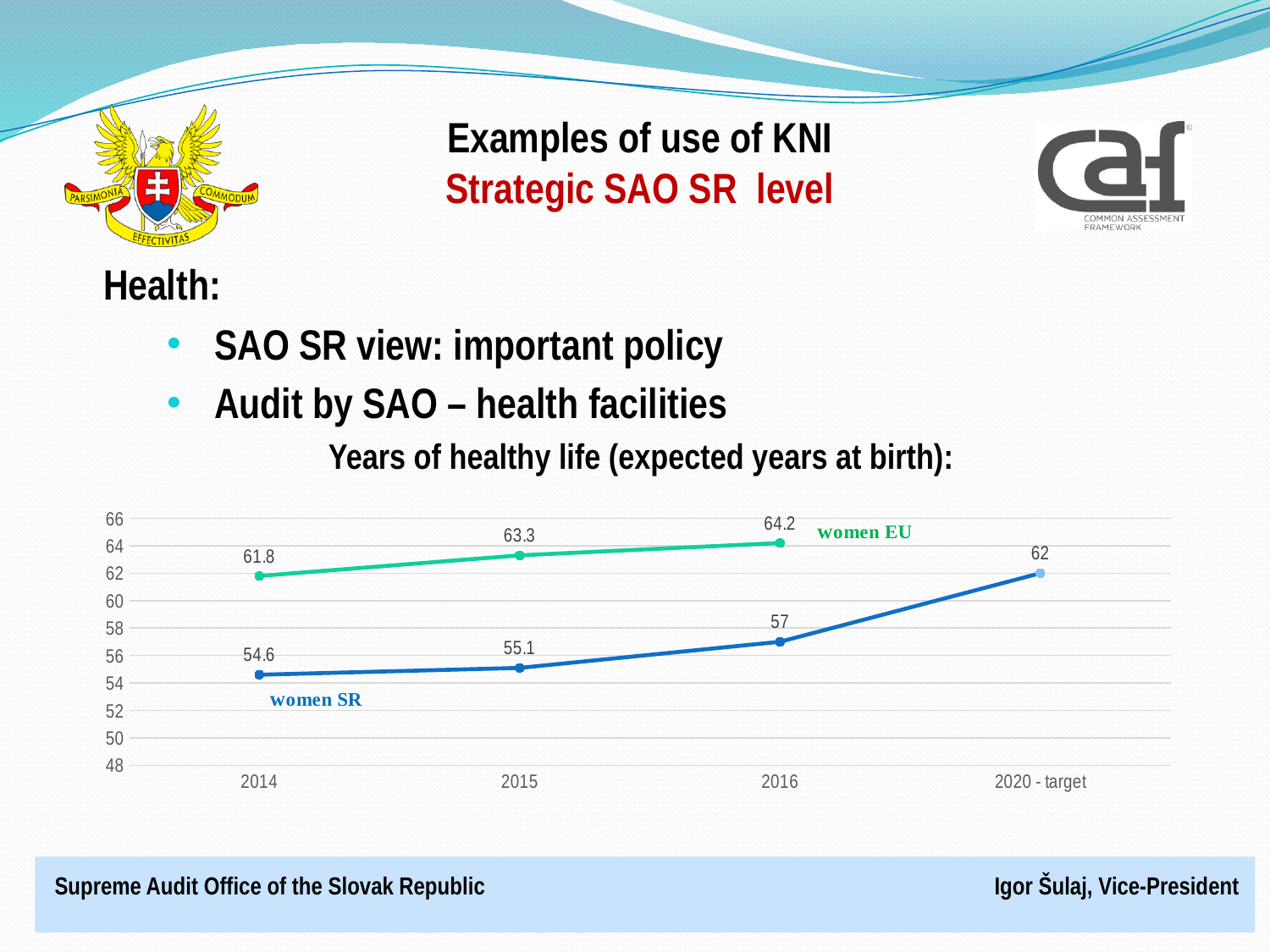
How many x-axis categories does the chart show? 4 What is the 2020 target value for women SR? 62 What is the value for women EU in 2016? 64.2 What is the value for women EU in 2015? 63.3 What kind of chart is shown? line chart Which is larger in 2016, women EU or women SR? women EU In which year is the women EU series highest? 2016 Does the women SR series rise or fall from 2014 to 2016? rise What is the difference between women EU and women SR in 2014? 7.2 How many series are plotted on the chart? 2 What is the value for women SR in 2014? 54.6 In which year is the women SR series lowest? 2014